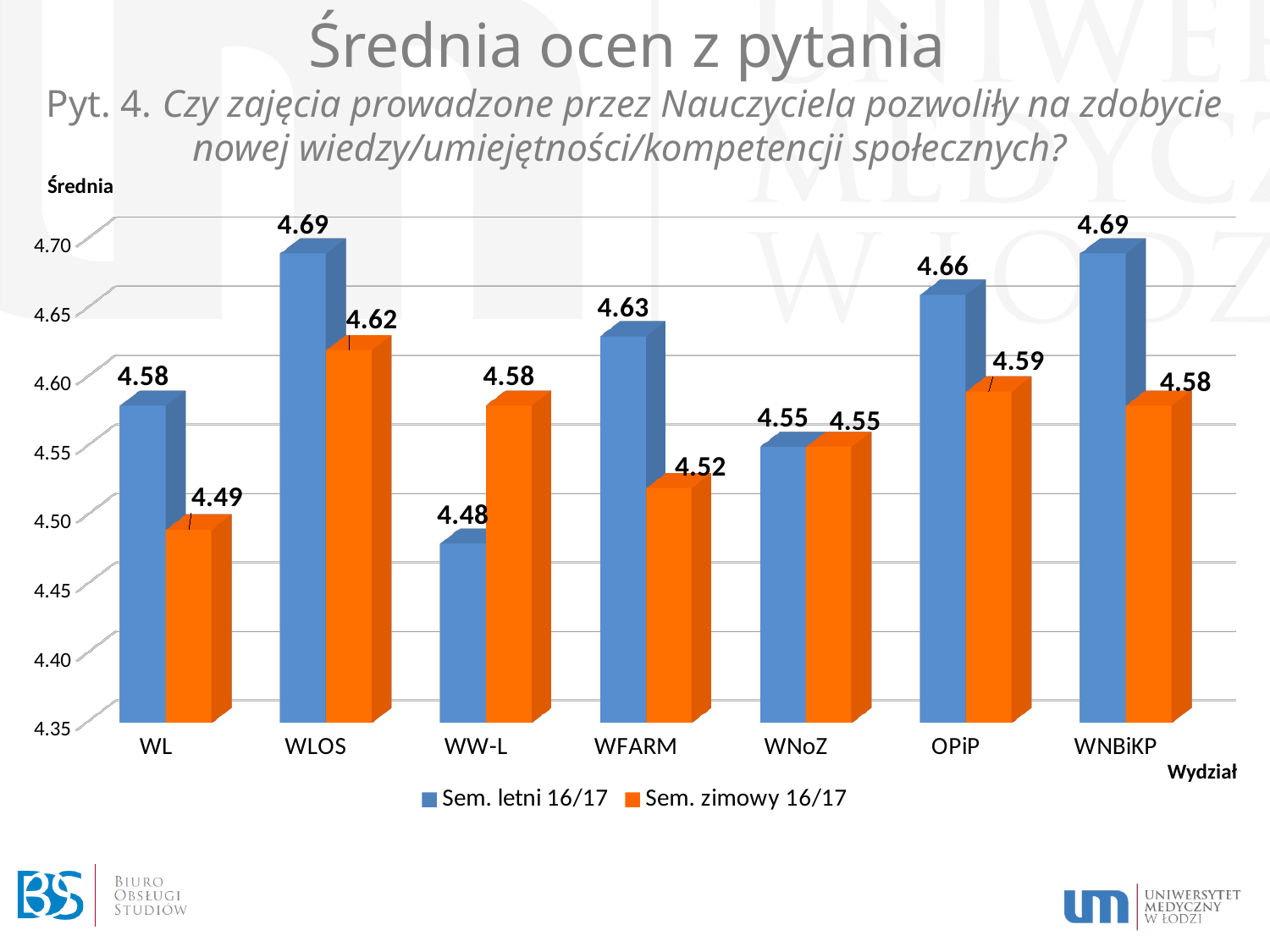
Which is larger for WW-L: the Sem. letni 16/17 value or the Sem. zimowy 16/17 value? Sem. zimowy 16/17 Is the Sem. letni 16/17 value for WNoZ greater or less than 4.60? less How many series does the legend list? 2 What is the value for OPiP in the Sem. zimowy 16/17 series? 4.59 Which category has the lowest value in the Sem. letni 16/17 series? WW-L How many categories (wydziały) are shown on the x axis? 7 Which category has the lowest value in the Sem. zimowy 16/17 series? WL What is the value for WFARM in the Sem. letni 16/17 series? 4.63 What is the value for WL in the Sem. zimowy 16/17 series? 4.49 Which category has the highest value in the Sem. zimowy 16/17 series? WLOS What kind of chart is shown on the slide? bar chart What is the difference between the Sem. letni 16/17 and Sem. zimowy 16/17 values for WFARM? 0.11